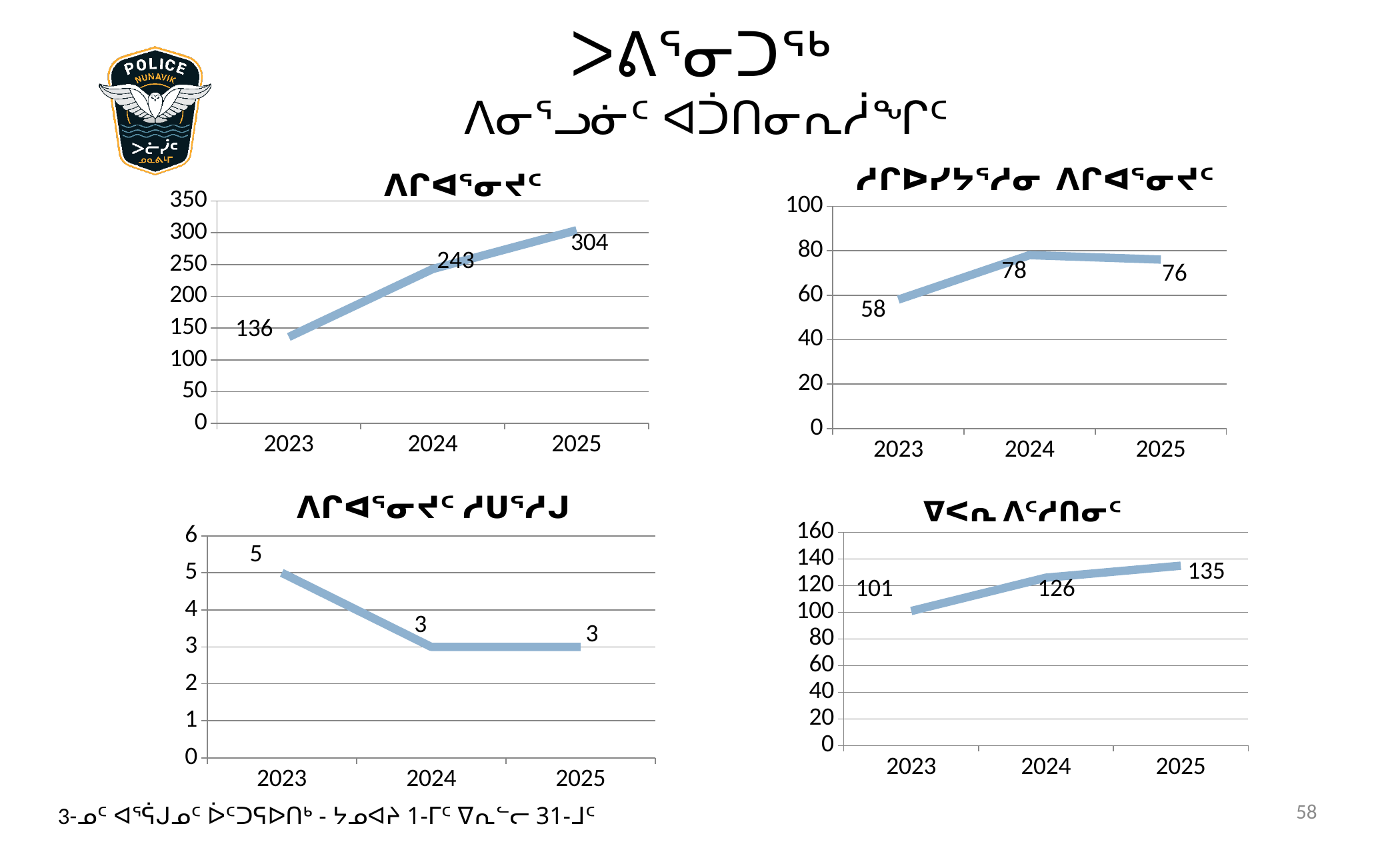
In the bottom-left chart, what is the value for 2023? 5 In the top-right chart, what is the value for 2023? 58 In the top-left chart, do the values rise or fall from 2023 to 2025? rise In the top-right chart, what is the difference between the 2024 and 2023 values? 20 In the bottom-right chart, which year has the lowest value? 2023 In the top-left chart, what is the value for 2025? 304 How many charts are on the slide, and what type are they? 4 line charts In the bottom-right chart, is the value for 2025 larger or smaller than the value for 2023? larger In the top-right chart, which year has the highest value? 2024 In the bottom-right chart, what is the value for 2024? 126 In the bottom-left chart, which year has the highest value? 2023 In the top-left chart, what is the difference between the 2025 and 2023 values? 168